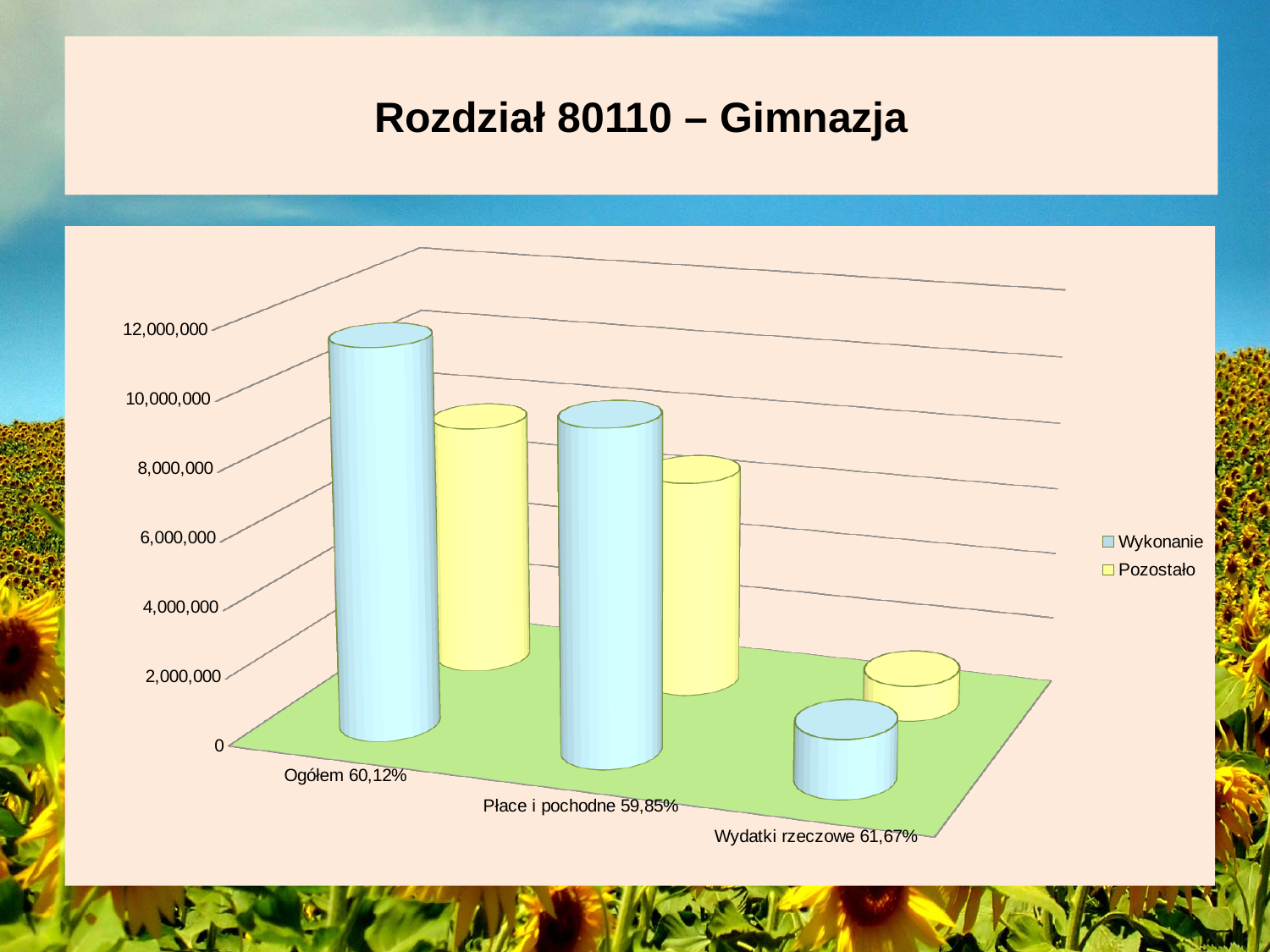
For Ogółem 60,12%, which is larger: Wykonanie or Pozostało? Wykonanie For Płace i pochodne 59,85%, which is larger: Wykonanie or Pozostało? Wykonanie What is the title of the slide? Rozdział 80110 – Gimnazja How many series does the legend list? 2 Which category has the lowest Wykonanie value? Wydatki rzeczowe 61,67% What kind of chart is shown on the slide? bar chart How many categories are shown on the x axis? 3 Is the Wykonanie value for Ogółem 60,12% greater or less than 8,000,000? greater Is the Wykonanie value for Wydatki rzeczowe 61,67% greater or less than 4,000,000? less Which category has the lowest Pozostało value? Wydatki rzeczowe 61,67% Which series is shown in yellow according to the legend? Pozostało Which category has the highest Wykonanie value? Ogółem 60,12%